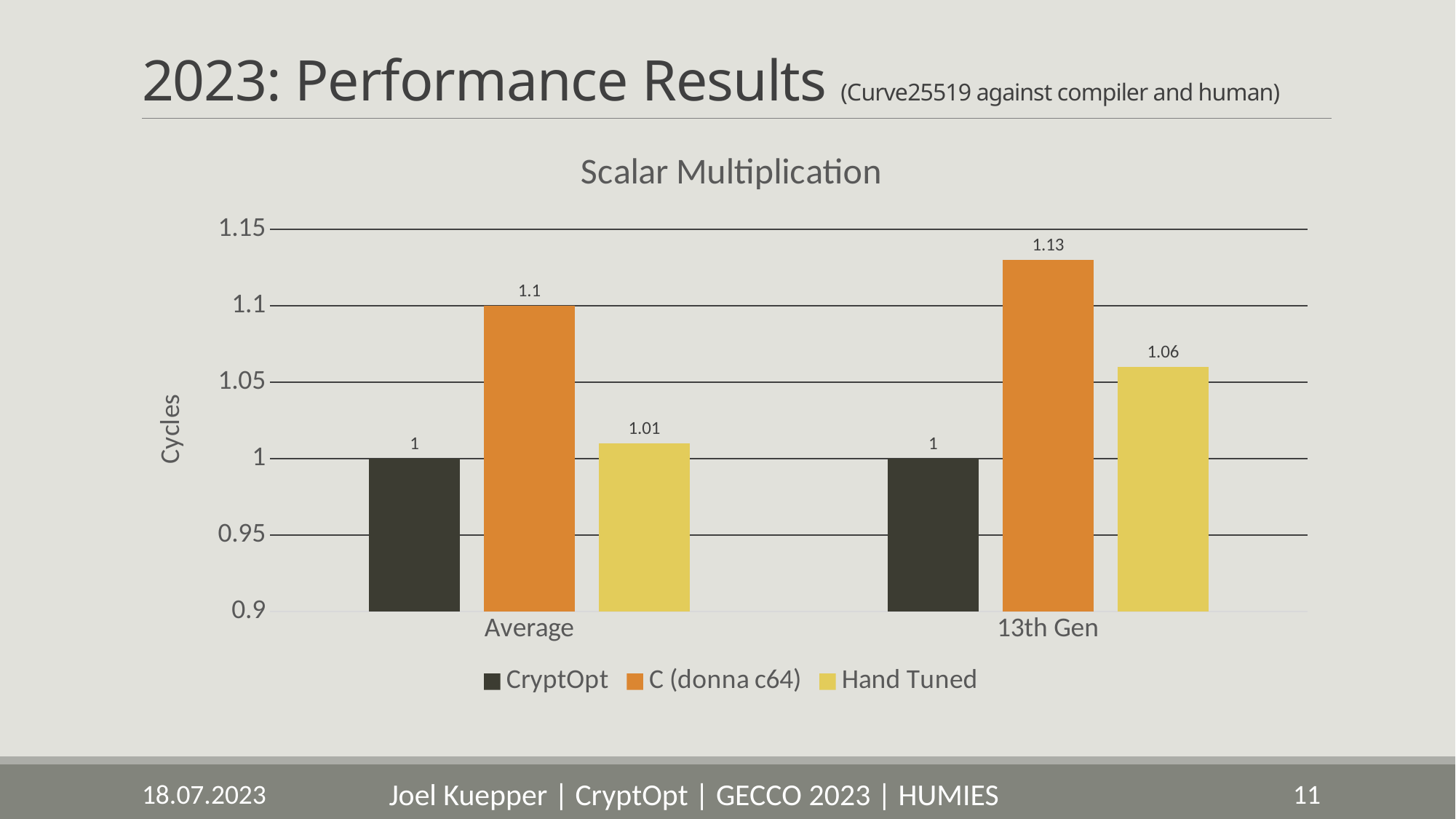
What is the value for Hand Tuned in the Average category? 1.01 How many categories are shown on the x axis? 2 What is the title of the chart? Scalar Multiplication Which series has the lowest value in the Average category? CryptOpt What kind of chart is shown on the slide? Bar chart What is the value for CryptOpt in the 13th Gen category? 1 Which is larger: the Hand Tuned value for Average or the Hand Tuned value for 13th Gen? 13th Gen What is the difference between the C (donna c64) value and the Hand Tuned value in the 13th Gen category? 0.07 Which series has the highest value in the 13th Gen category? C (donna c64) How many series does the legend list? 3 What is the value for C (donna c64) in the Average category? 1.1 What is the value for Hand Tuned in the 13th Gen category? 1.06